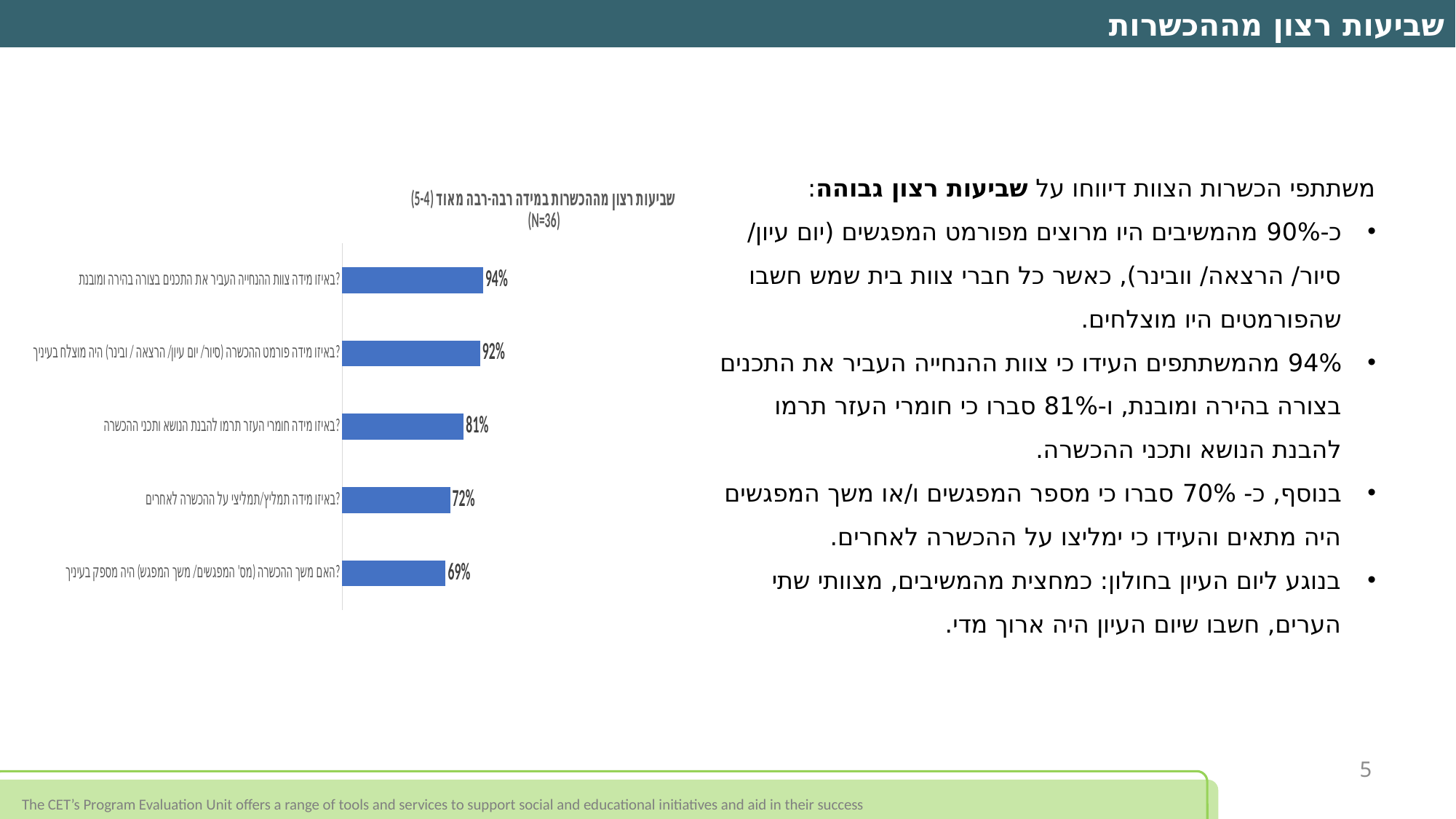
How many categories (questions) are plotted in the chart? 5 What is the value for the category 'באיזו מידה תמליץ/תמליצי על ההכשרה לאחרים?' 72% What type of chart is shown on the slide? bar chart Which category has the highest value in the chart? באיזו מידה צוות ההנחייה העביר את התכנים בצורה בהירה ומובנת? What is the value for the category 'באיזו מידה צוות ההנחייה העביר את התכנים בצורה בהירה ומובנת?' 94% What sample size (N) is stated in the chart title? N=36 What is the difference between the highest value (94%) and the lowest value (69%) in the chart? 25% Which category has the lowest value in the chart? האם משך ההכשרה (מס' המפגשים/ משך המפגש) היה מספק בעיניך? What is the value for the category 'באיזו מידה פורמט ההכשרה (סיור/ יום עיון/ הרצאה / ובינר) היה מוצלח בעיניך?' 92% What is the value for the category 'באיזו מידה חומרי העזר תרמו להבנת הנושא ותכני ההכשרה?' 81% Which is larger: the value for 'באיזו מידה חומרי העזר תרמו להבנת הנושא ותכני ההכשרה?' or the value for 'באיזו מידה תמליץ/תמליצי על ההכשרה לאחרים?' באיזו מידה חומרי העזר תרמו להבנת הנושא ותכני ההכשרה? What is the value for the category 'האם משך ההכשרה (מס' המפגשים/ משך המפגש) היה מספק בעיניך?' 69%